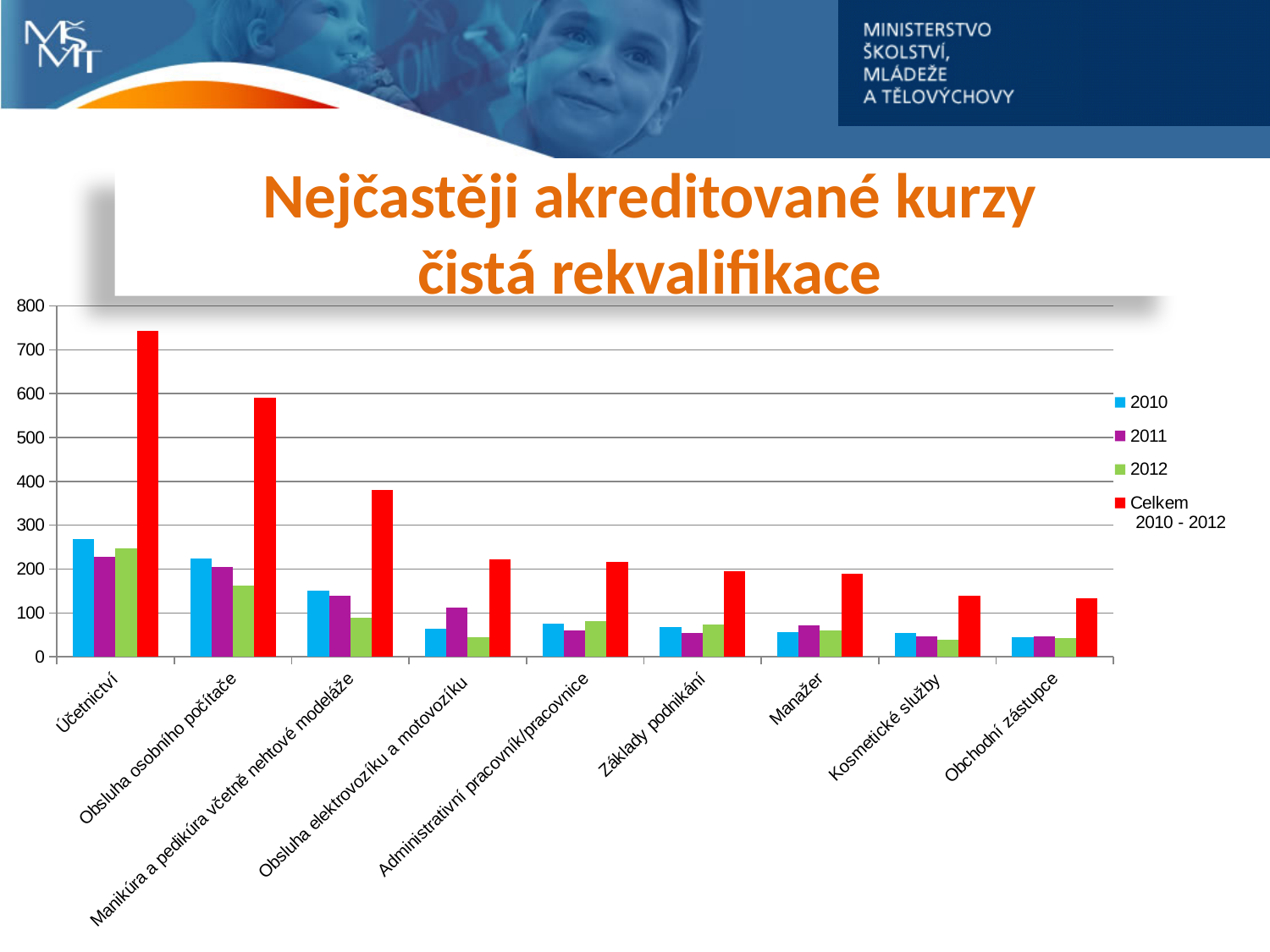
How many series does the legend list? 4 What is the title of the chart on the slide? Nejčastěji akreditované kurzy čistá rekvalifikace Is the Celkem 2010 - 2012 value for Obsluha osobního počítače greater or less than 500? greater Is the 2010 value for Účetnictví greater or less than 200? greater Is the 2012 value for Obsluha elektrovozíku a motovozíku greater or less than 100? less What kind of chart is shown on the slide? bar chart Which category has the highest value for Celkem 2010 - 2012? Účetnictví Do the Celkem 2010 - 2012 values rise or fall moving from left to right along the x axis? fall How many course categories are shown on the x axis? 9 For Obsluha osobního počítače, which is larger: the 2010 value or the 2012 value? 2010